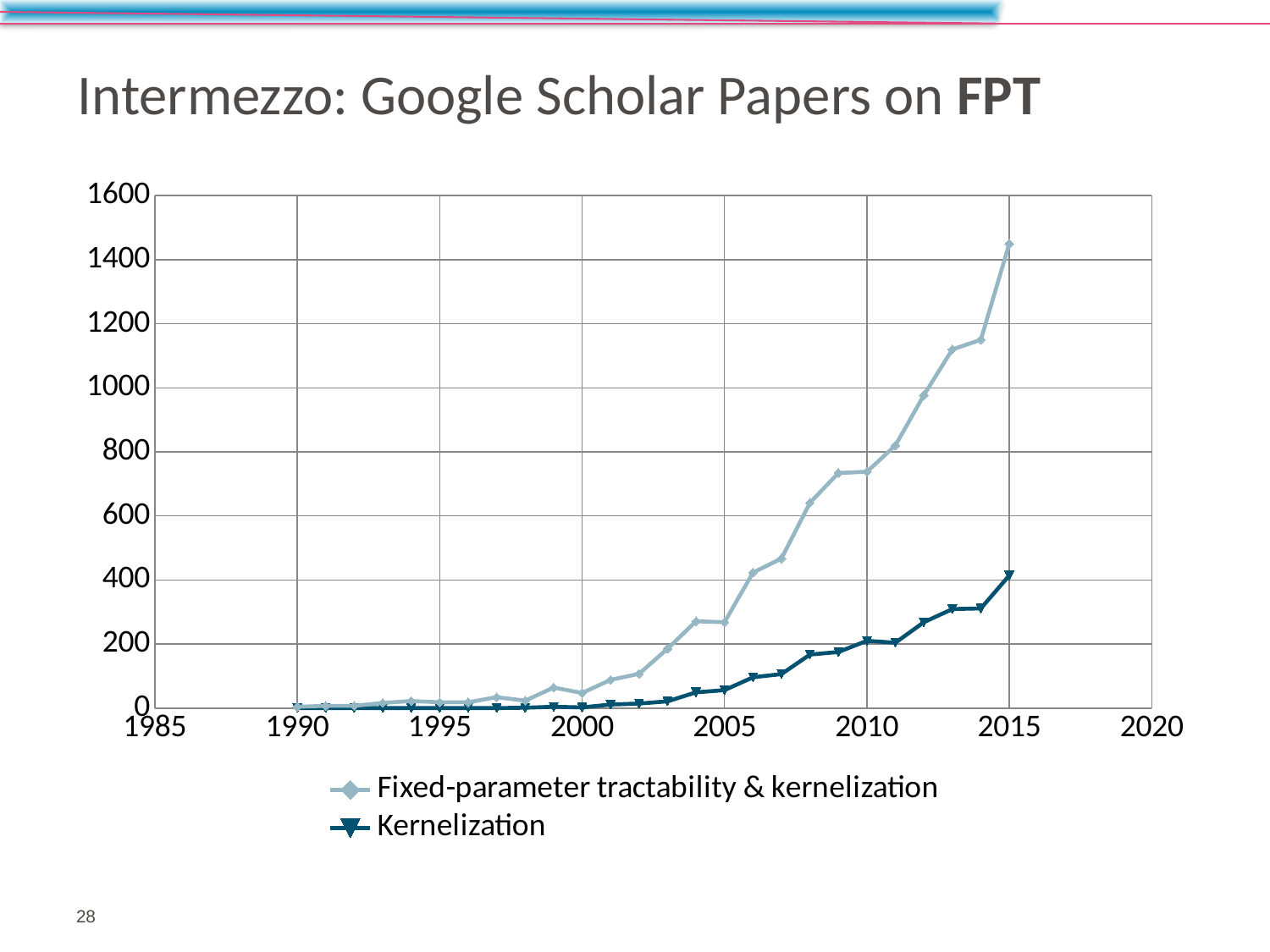
Is the value for Fixed-parameter tractability & kernelization in 2015 greater or less than 1400? greater What is the title of the slide containing the chart? Intermezzo: Google Scholar Papers on FPT In 2015, which series has the larger value: Fixed-parameter tractability & kernelization or Kernelization? Fixed-parameter tractability & kernelization In which year does the Kernelization series reach its highest value? 2015 Do the values for the Kernelization series rise or fall from 2000 to 2015? Rise Is the value for Kernelization in 2015 greater or less than 600? less What kind of chart is shown on the slide? Line chart In which year does the Fixed-parameter tractability & kernelization series reach its highest value? 2015 Do the values for the Fixed-parameter tractability & kernelization series rise or fall from 1990 to 2015? Rise What are the two series named in the legend? Fixed-parameter tractability & kernelization; Kernelization Is the value for Fixed-parameter tractability & kernelization in 2010 greater or less than 600? greater How many series does the legend list? 2